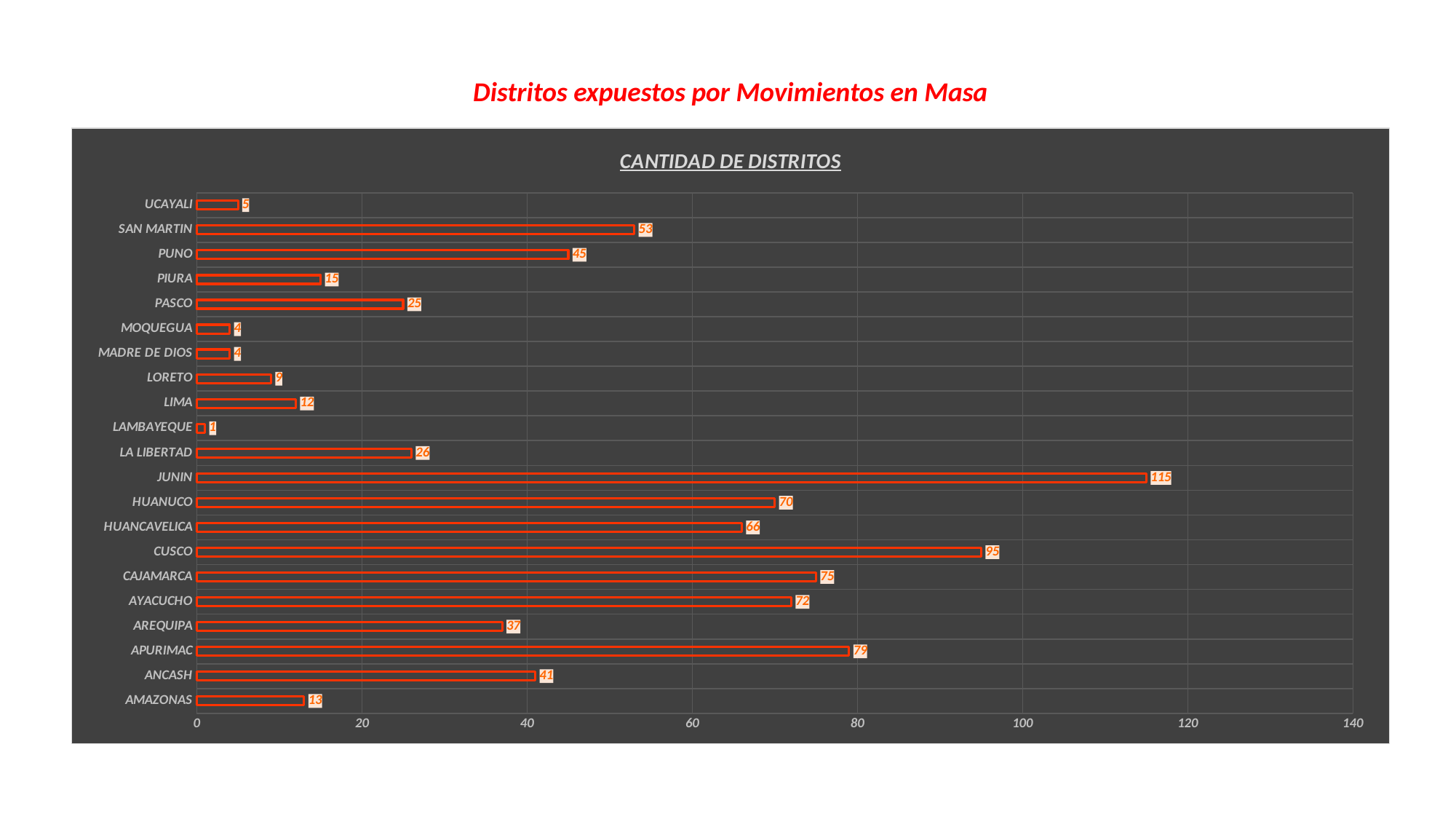
Which category has the highest value? JUNIN Which category has the lowest value? LAMBAYEQUE Is the value for CAJAMARCA greater or less than 60? greater What is the value for LAMBAYEQUE? 1 What is the value for JUNIN? 115 What kind of chart is shown on the slide? bar chart How many categories are shown in the chart? 21 What is the value for CUSCO? 95 Which is larger, the value for HUANUCO or the value for HUANCAVELICA? HUANUCO What is the difference between the values for JUNIN and CUSCO? 20 What is the value for SAN MARTIN? 53 What is the difference between the values for APURIMAC and ANCASH? 38